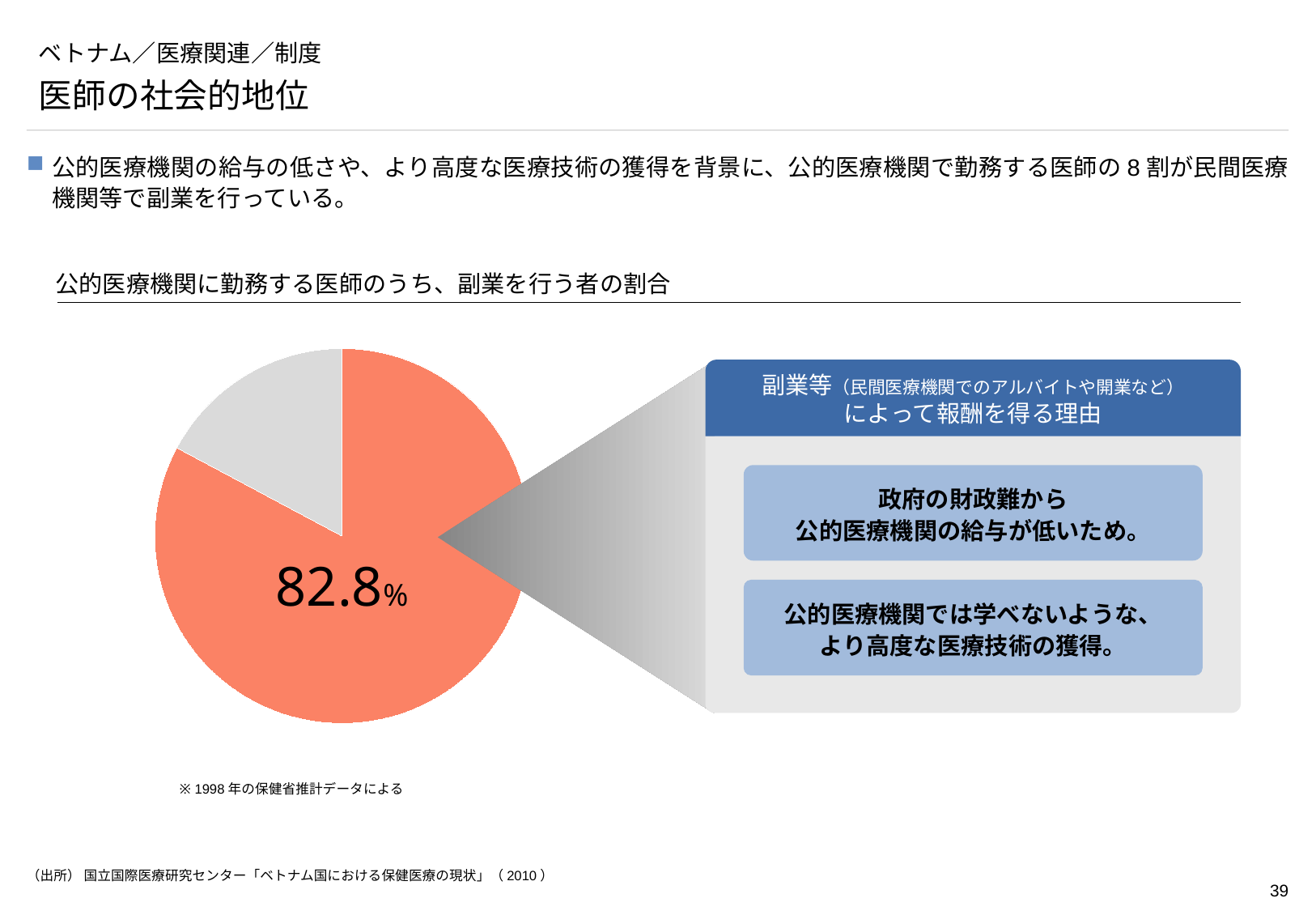
What percentage of doctors working at public medical institutions have a side job, according to the pie chart? 82.8% What is the title of the pie chart? 公的医療機関に勤務する医師のうち、副業を行う者の割合 What share of the pie does the orange slice represent? 82.8% What colour is the slice labelled 82.8%? Orange Which slice of the pie chart is larger, the orange one or the gray one? The orange one Is the share of the gray slice greater or less than 25%? less What kind of chart is shown on the slide? Pie chart Is the share shown for the orange slice greater or less than 50%? greater How many slices does the pie chart have? 2